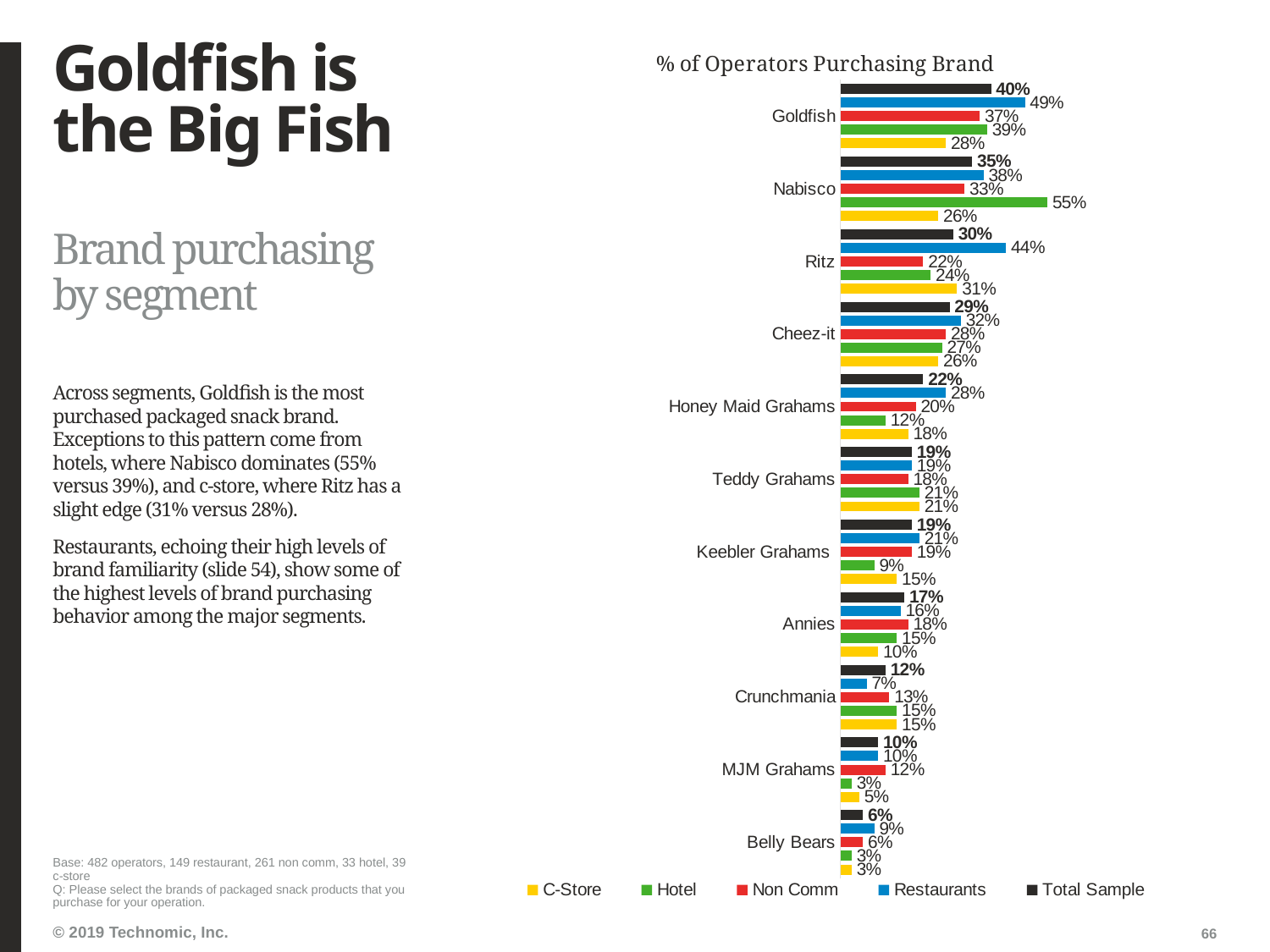
What is the Total Sample value for Goldfish? 40% How many series does the legend list? 5 What is the Hotel value for Nabisco? 55% What is the difference between the Restaurants value and the C-Store value for Goldfish? 21% For Ritz, which is larger: the Restaurants value or the Non Comm value? Restaurants What is the Hotel value for Keebler Grahams? 9% What is the C-Store value for Ritz? 31% Which colour represents the Hotel series in the legend? Green What kind of chart is shown on the slide? Bar chart How many brands are shown on the chart? 11 Which brand has the lowest Total Sample value? Belly Bears Which brand has the highest Total Sample value? Goldfish